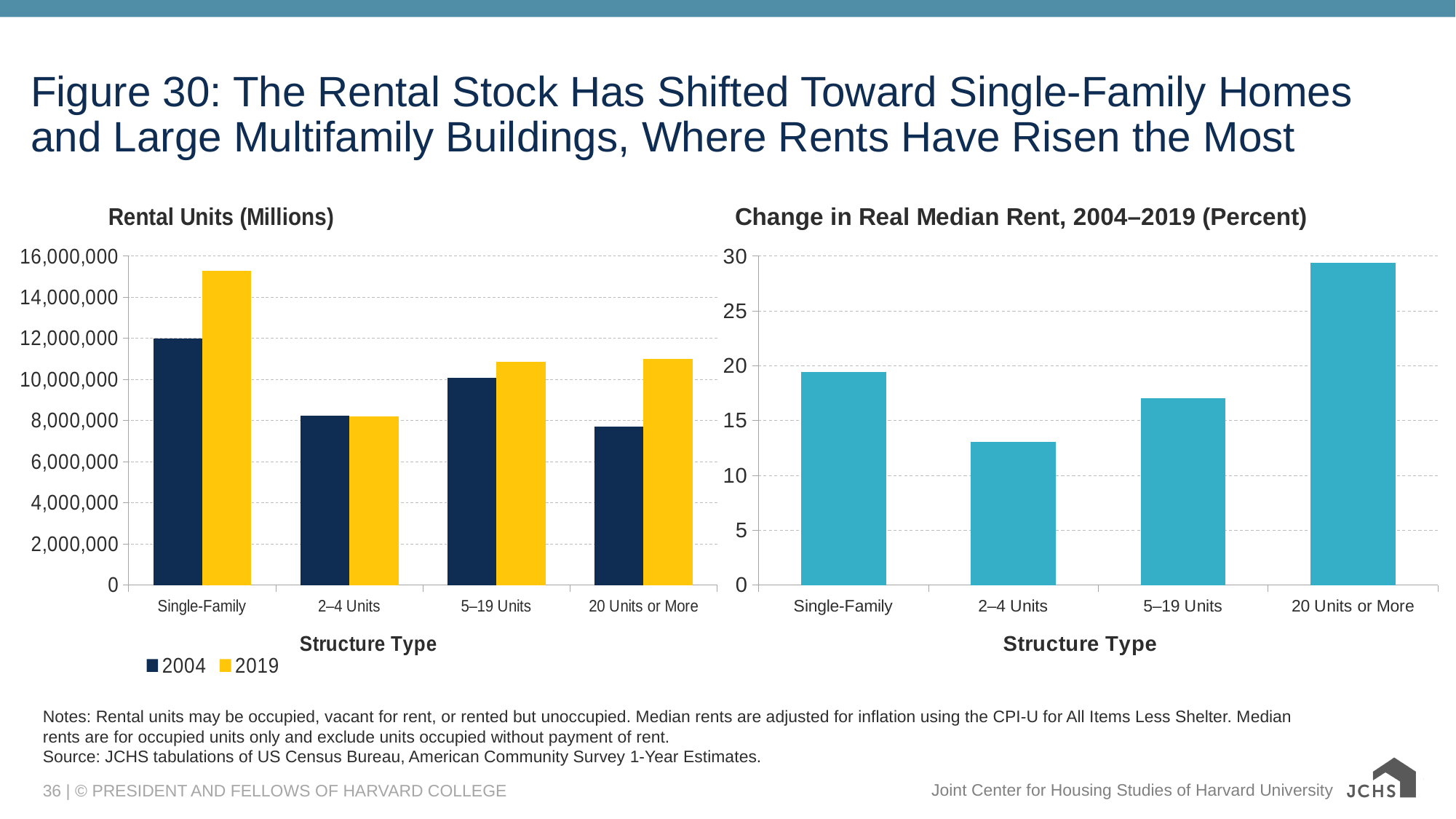
In the 'Rental Units (Millions)' chart, how many series does the legend list? 2 In the 'Change in Real Median Rent, 2004–2019 (Percent)' chart, which structure type has the highest value? 20 Units or More In the 'Rental Units (Millions)' chart, which structure type has the highest 2019 value? Single-Family In the 'Rental Units (Millions)' chart, which structure type has the lowest 2004 value? 20 Units or More In the 'Rental Units (Millions)' chart, is the 2019 value for Single-Family greater or less than 14,000,000? greater What are the two legend entries in the 'Rental Units (Millions)' chart? 2004 and 2019 In the 'Change in Real Median Rent, 2004–2019 (Percent)' chart, is the value for Single-Family greater or less than 15? greater In the 'Rental Units (Millions)' chart, for 20 Units or More, which year has the larger value, 2004 or 2019? 2019 In the 'Change in Real Median Rent, 2004–2019 (Percent)' chart, how many structure types are shown? 4 What kind of chart is the 'Rental Units (Millions)' chart on the left? bar chart In the 'Change in Real Median Rent, 2004–2019 (Percent)' chart, is the value for 20 Units or More greater or less than 25? greater In the 'Change in Real Median Rent, 2004–2019 (Percent)' chart, which structure type has the lowest value? 2–4 Units